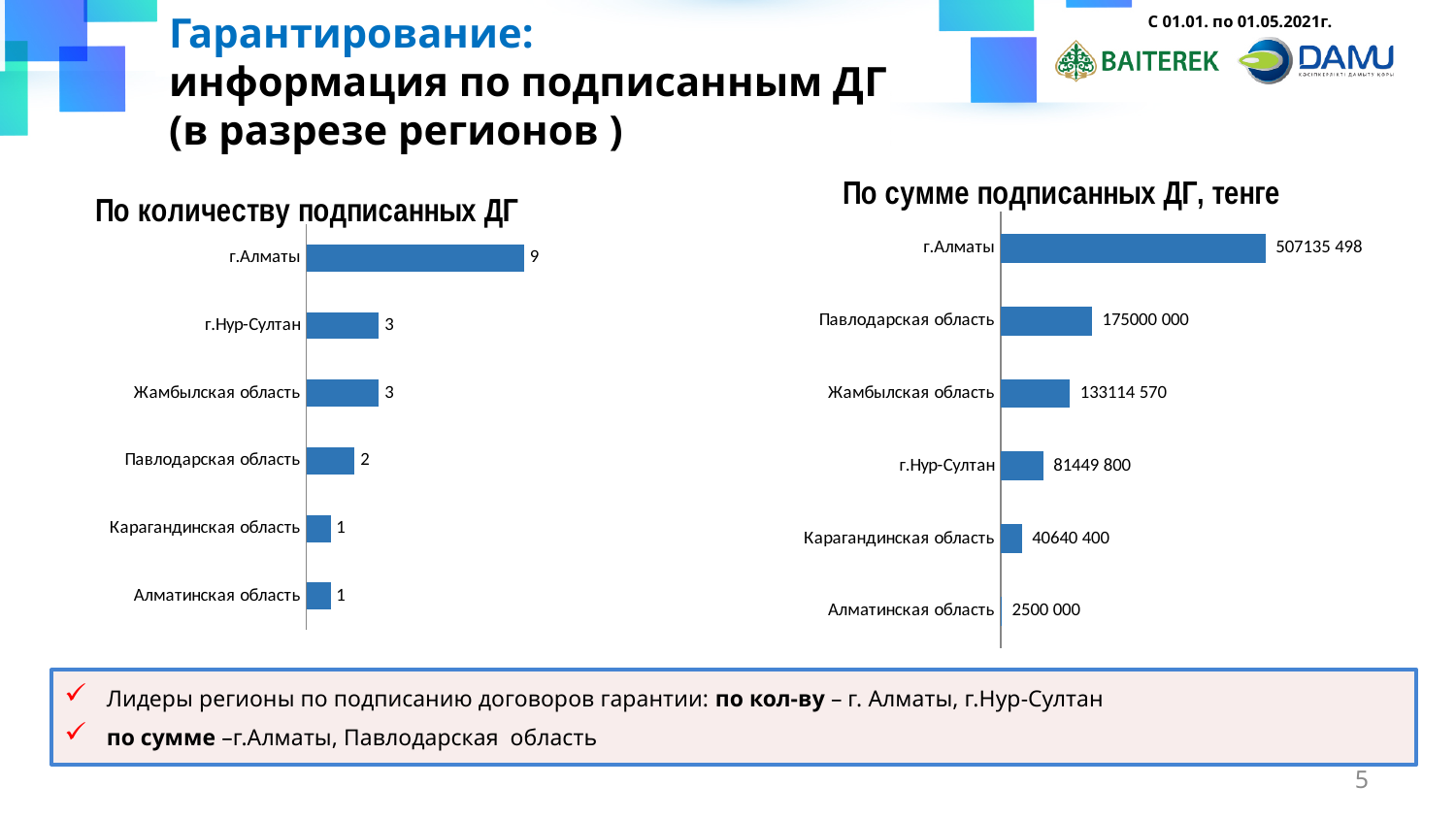
In the chart 'По сумме подписанных ДГ, тенге', which is larger: Жамбылская область or г.Нур-Султан? Жамбылская область In the chart 'По сумме подписанных ДГ, тенге', what is the value for Карагандинская область? 40640 400 In the chart 'По количеству подписанных ДГ', what is the value for Павлодарская область? 2 In the chart 'По сумме подписанных ДГ, тенге', what is the value for г.Алматы? 507135 498 What type of chart is 'По сумме подписанных ДГ, тенге'? bar chart In the chart 'По сумме подписанных ДГ, тенге', which category has the lowest value? Алматинская область In the chart 'По количеству подписанных ДГ', how many categories are shown? 6 In the chart 'По сумме подписанных ДГ, тенге', what is the value for Павлодарская область? 175000 000 In the chart 'По количеству подписанных ДГ', which category has the highest value? г.Алматы How many charts are on the slide? 2 In the chart 'По количеству подписанных ДГ', what is the value for г.Алматы? 9 In the chart 'По количеству подписанных ДГ', what is the difference between г.Алматы and г.Нур-Султан? 6